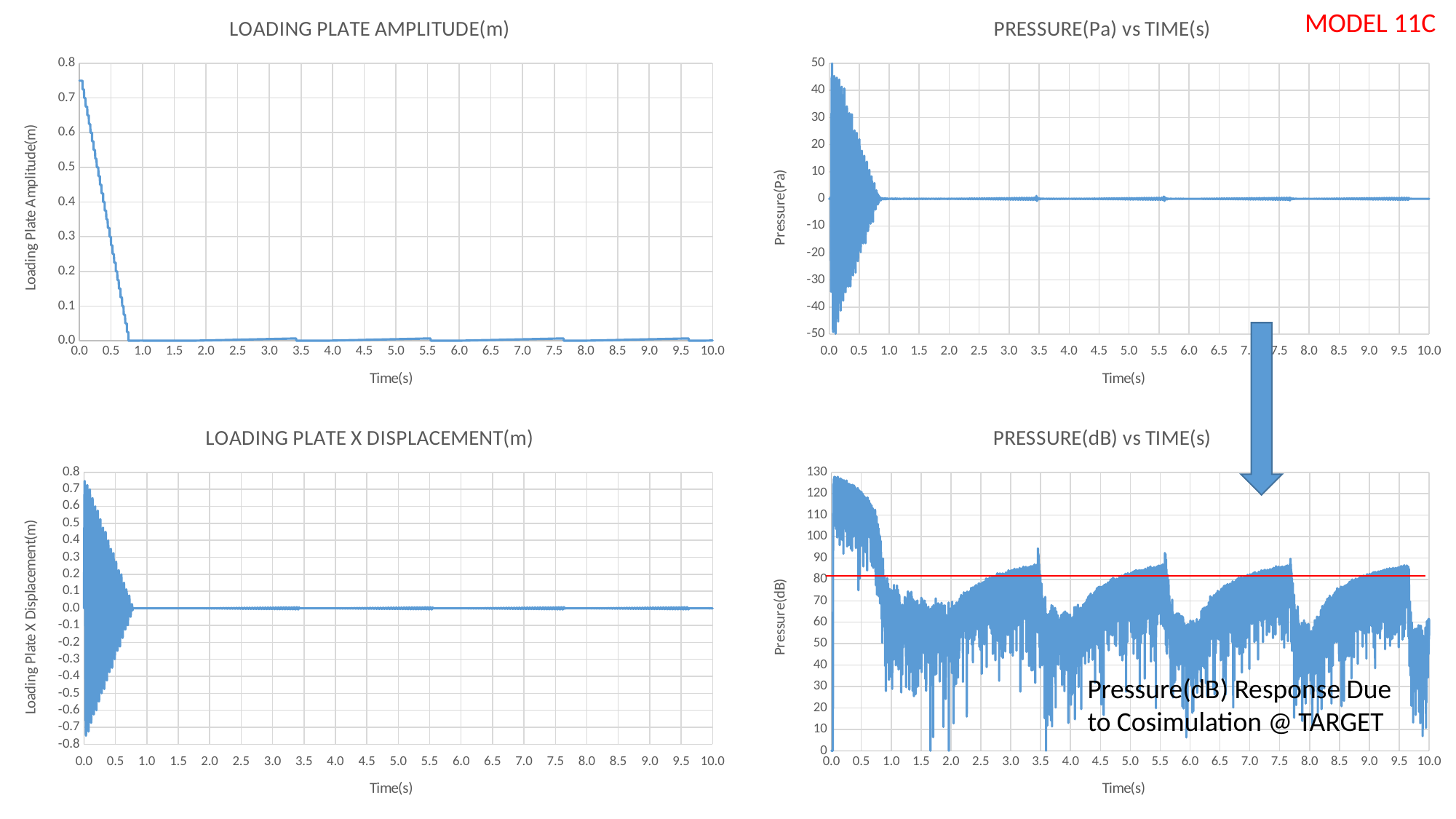
In the PRESSURE(dB) vs TIME(s) chart, which is larger: the pressure at time 0.0 s or at time 5.0 s? 0.0 s What kind of chart is the LOADING PLATE AMPLITUDE(m) chart? line chart In the PRESSURE(Pa) vs TIME(s) chart, is the pressure at time 5.0 s greater or less than 10? less In the PRESSURE(dB) vs TIME(s) chart, is the value at time 0.0 s greater or less than 100? greater How many charts are shown on the slide? 4 In the LOADING PLATE AMPLITUDE(m) chart, does the value rise or fall between 0.0 s and 1.0 s? fall In the LOADING PLATE AMPLITUDE(m) chart, is the value at time 0.0 s greater or less than 0.5? greater In the PRESSURE(dB) vs TIME(s) chart, at what level is the red horizontal line drawn? 80 What is the x-axis label on the PRESSURE(dB) vs TIME(s) chart? Time(s)